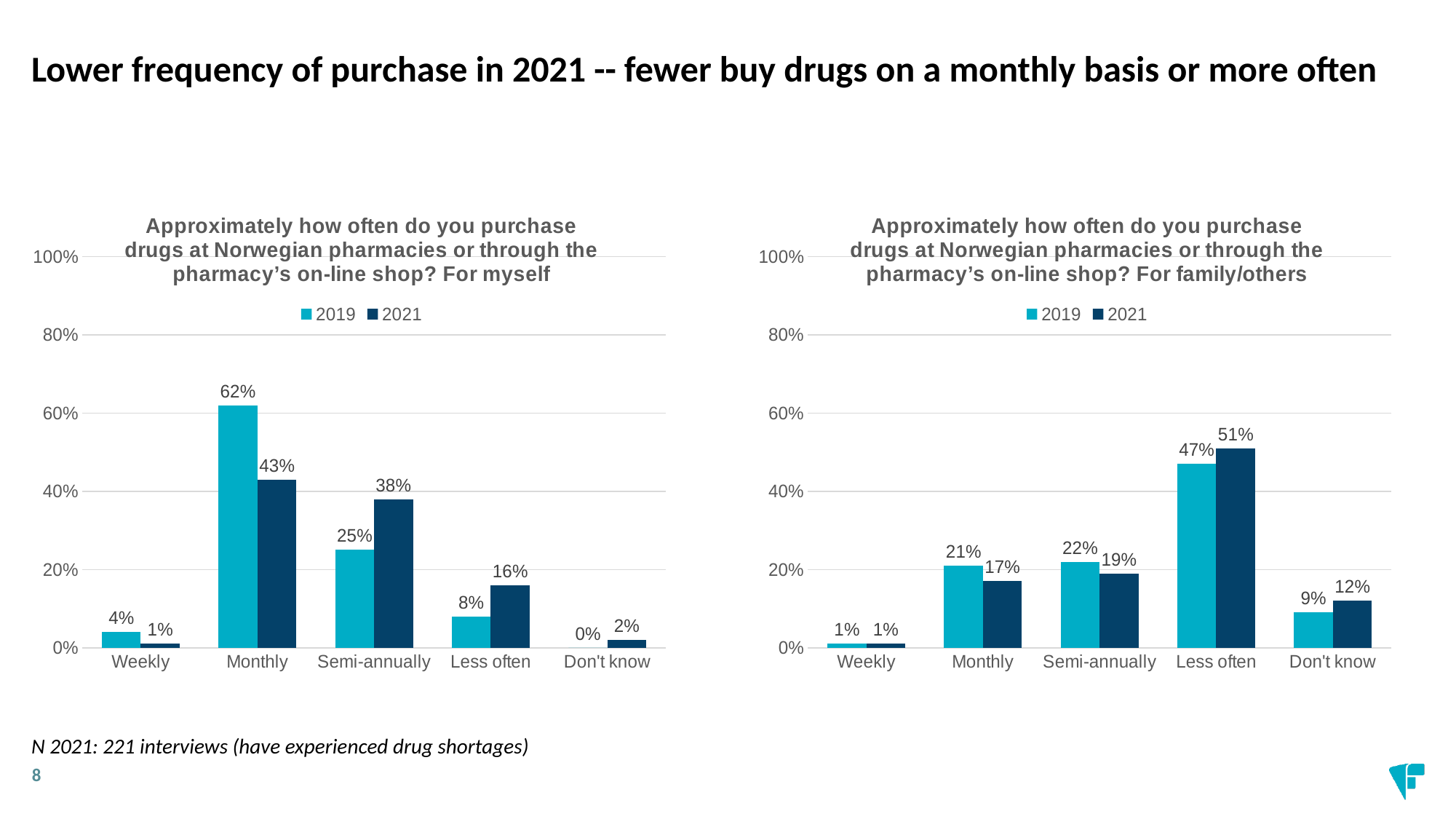
In the 'For myself' chart on the left, what is the 2021 value for Semi-annually? 38% In the 'For myself' chart on the left, what is the difference between the 2019 and 2021 values for Monthly? 19% In the 'For myself' chart on the left, what is the 2019 value for Monthly? 62% In the 'For family/others' chart on the right, what is the 2021 value for Less often? 51% In the 'For family/others' chart on the right, what is the 2019 value for Don't know? 9% In the 'For family/others' chart on the right, which is larger for Semi-annually: the 2019 value or the 2021 value? 2019 How many series does the legend of the 'For family/others' chart on the right list? 2 What kind of chart is the 'For myself' chart on the left? Bar chart In the 'For family/others' chart on the right, what is the difference between the 2021 and 2019 values for Don't know? 3% How many categories are shown on the x axis of the 'For myself' chart on the left? 5 In the 'For family/others' chart on the right, which category has the lowest 2021 value? Weekly In the 'For myself' chart on the left, which category has the highest 2019 value? Monthly